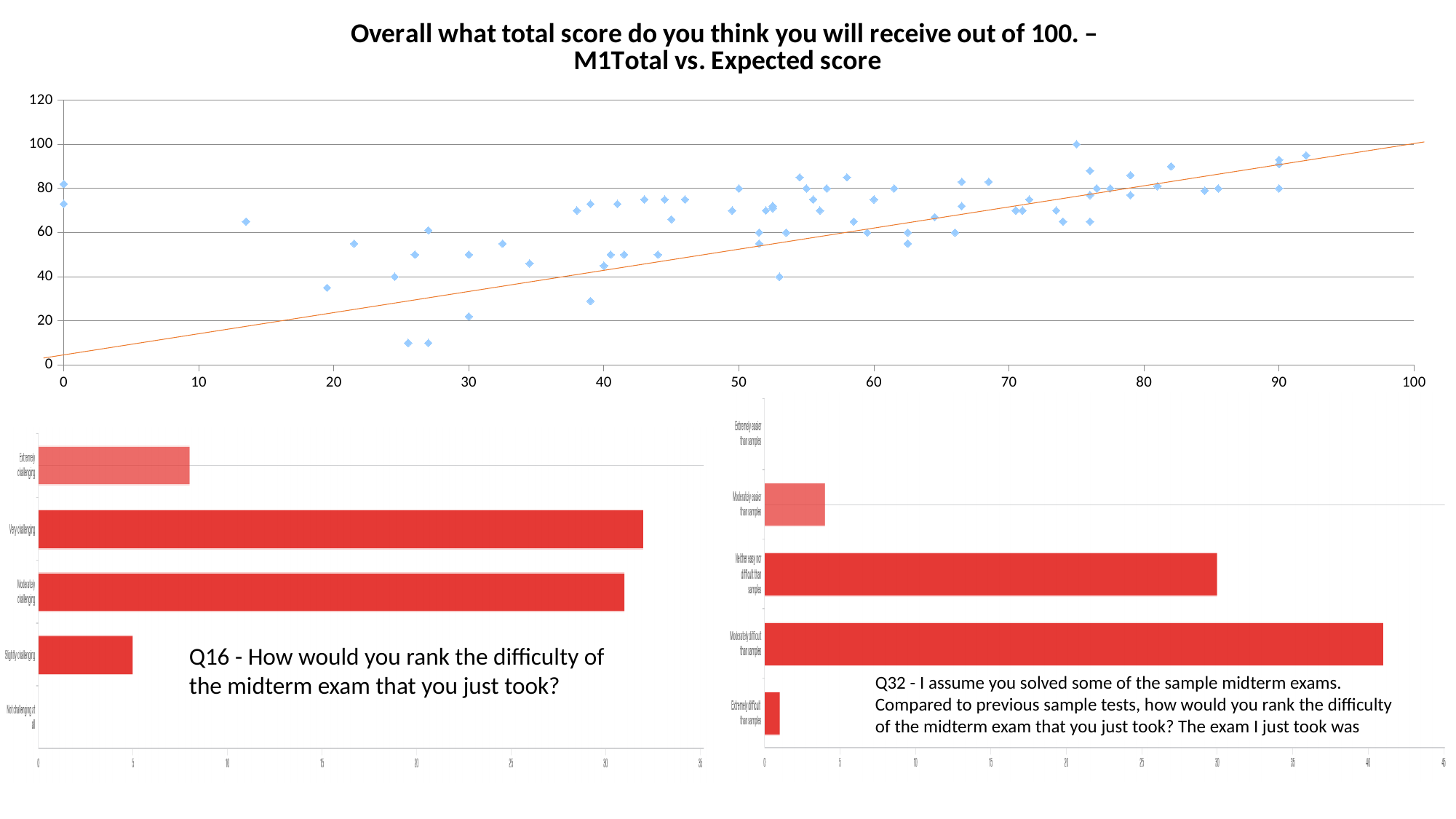
In the top scatter chart, do the plotted points generally rise or fall as the x-axis value increases? rise In the bottom-right Q32 chart, is the value for Moderately easier than samples greater or less than 10? less What kind of chart is the top chart titled "M1Total vs. Expected score"? scatter chart In the bottom-left Q16 chart, how many categories are shown? 5 In the top scatter chart, what is the highest value shown on the vertical axis? 120 In the bottom-right Q32 chart, which category has the highest value? Moderately difficult than samples In the bottom-right Q32 chart, is the value for Neither easy nor difficult than samples greater or less than 25? greater In the bottom-left Q16 chart, which category has the lowest value? Not challenging at all What kind of chart is the bottom-left Q16 chart? bar chart In the bottom-left Q16 chart, is the value for Extremely challenging greater or less than 10? less In the bottom-left Q16 chart, which is larger, Extremely challenging or Slightly challenging? Extremely challenging